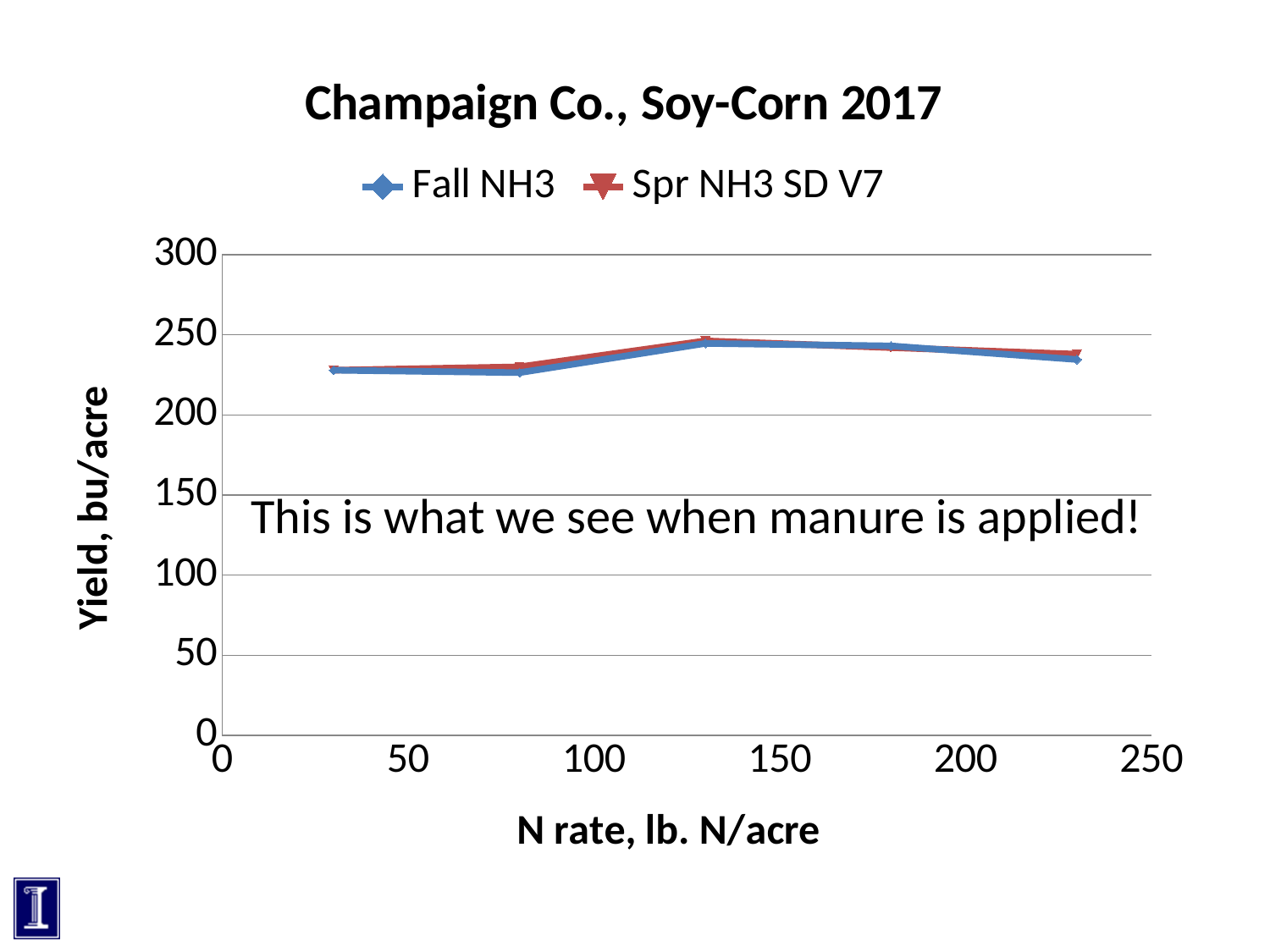
At which N rate does the Fall NH3 series reach its highest yield? 130 Is the Fall NH3 yield at an N rate of 230 greater or less than 200? greater What are the two series named in the legend? Fall NH3 and Spr NH3 SD V7 How many series does the legend list? 2 Is the Spr NH3 SD V7 yield at an N rate of 30 greater or less than 250? less Is the Fall NH3 yield at an N rate of 130 greater or less than 200? greater What kind of chart is shown on the slide? line chart What is the title of the chart? Champaign Co., Soy-Corn 2017 How many data points are plotted for the Fall NH3 series? 5 Does the Spr NH3 SD V7 yield rise or fall between N rates of 130 and 230? fall Does the Fall NH3 yield rise or fall between N rates of 80 and 130? rise